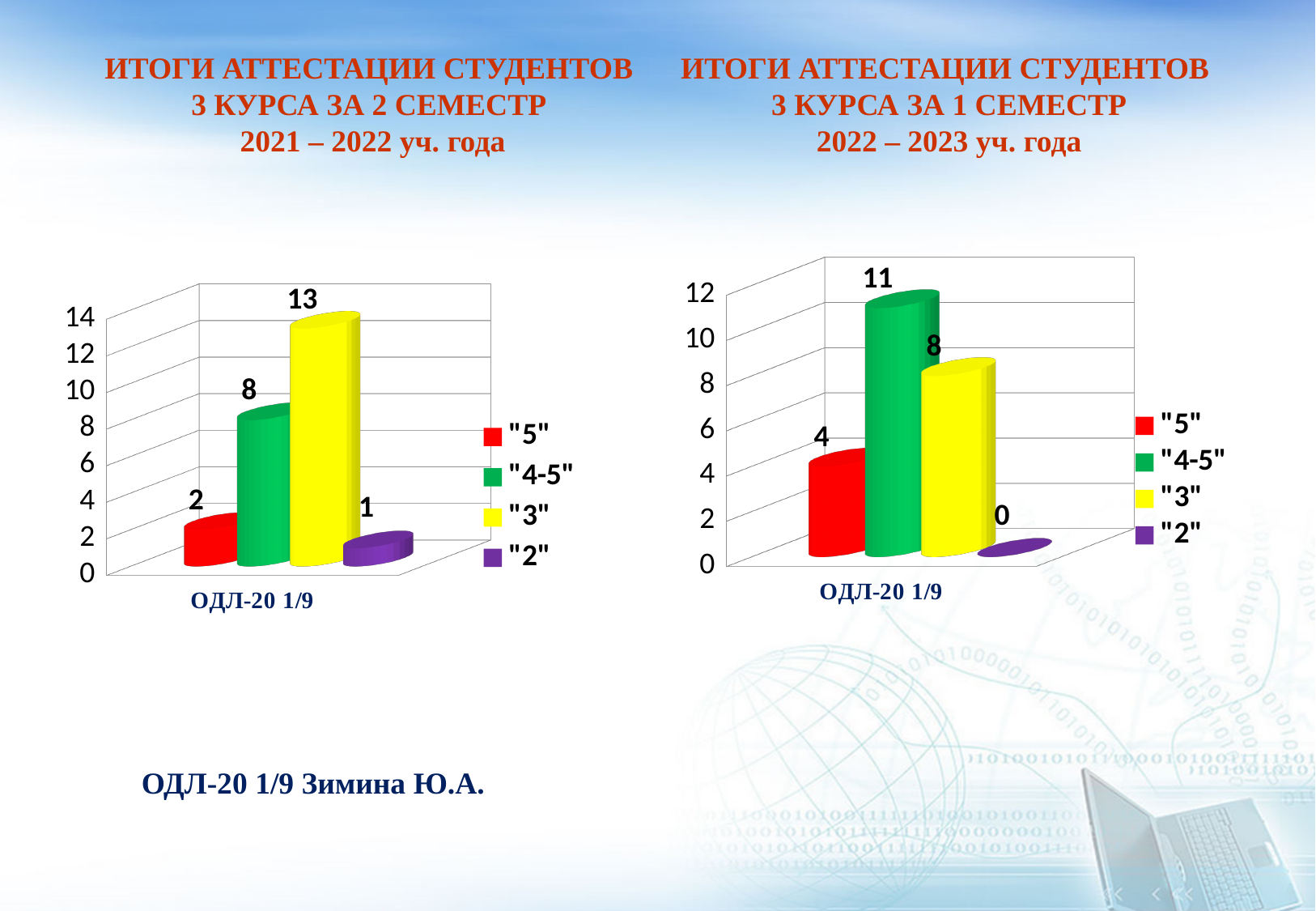
How many series does the legend of the left chart (2 семестр 2021–2022) list? 4 In the right chart (1 семестр 2022–2023), which is larger: the value for "4-5" or the value for "3"? "4-5" In the left chart (2 семестр 2021–2022), what is the value for "3"? 13 In the right chart (1 семестр 2022–2023), what colour is the bar for "5"? Red What kind of chart is the right chart (1 семестр 2022–2023)? Bar chart In the right chart (1 семестр 2022–2023), what is the value for "4-5"? 11 In the left chart (2 семестр 2021–2022), which series has the highest value? "3" In the right chart (1 семестр 2022–2023), what is the value for "2"? 0 In the right chart (1 семестр 2022–2023), what is the difference between the values for "4-5" and "5"? 7 In the left chart (2 семестр 2021–2022), what is the value for "5"? 2 In the left chart (2 семестр 2021–2022), what is the difference between the values for "3" and "4-5"? 5 In the right chart (1 семестр 2022–2023), which series has the lowest value? "2"